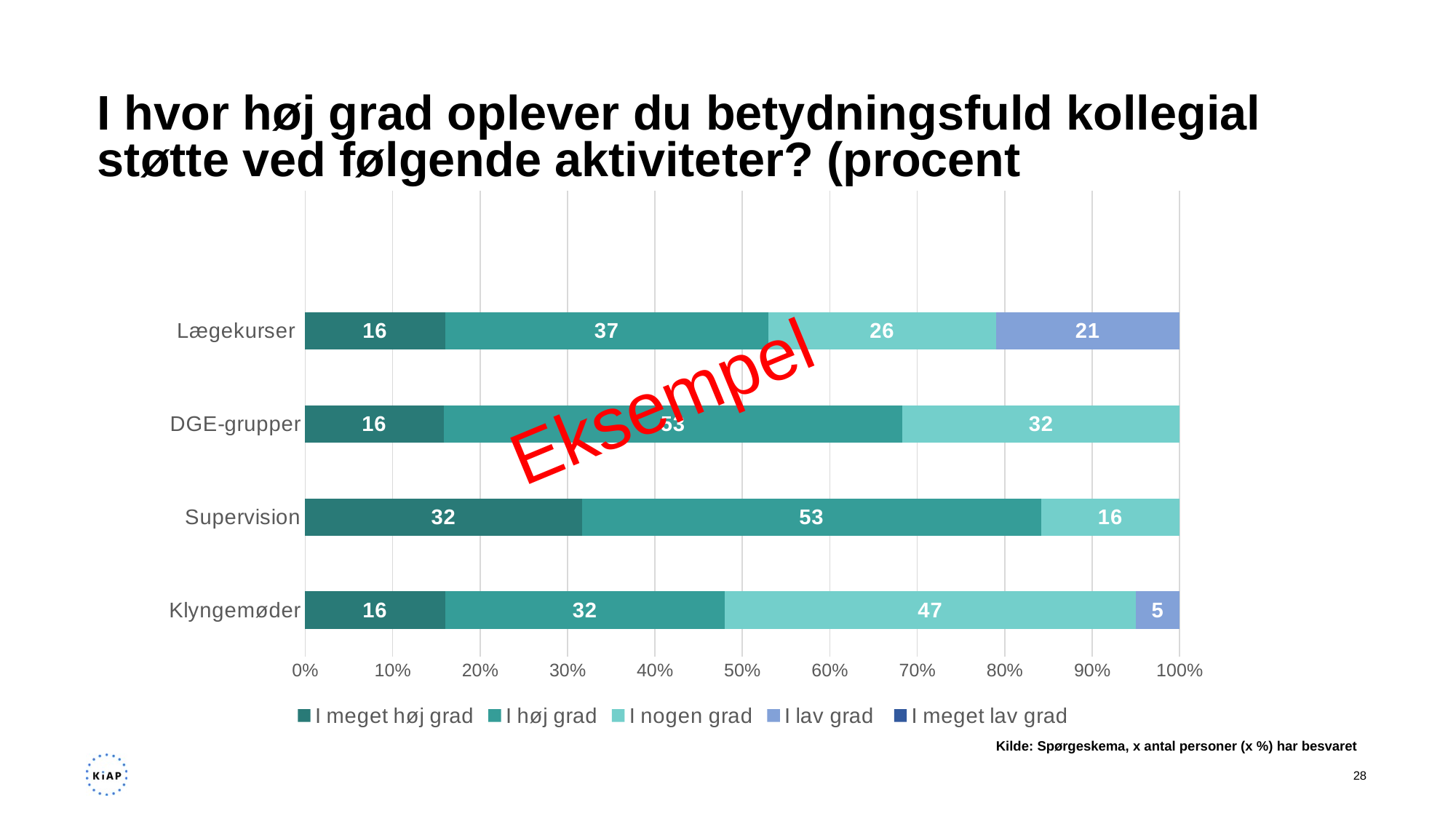
What is the difference between the 'I høj grad' value for Supervision and the 'I høj grad' value for Klyngemøder? 21 What is the value of 'I nogen grad' for Klyngemøder? 47 What is the value of 'I lav grad' for Lægekurser? 21 How many activities (categories) are shown on the chart? 4 How many series does the legend list? 5 Which activity has the highest value for 'I meget høj grad'? Supervision Is the 'I høj grad' value for Supervision greater or less than the 'I høj grad' value for Lægekurser? greater What type of chart is shown on the slide? stacked bar chart Which activity has the highest value for 'I nogen grad'? Klyngemøder What is the value of 'I høj grad' for Lægekurser? 37 What is the value of 'I nogen grad' for DGE-grupper? 32 What is the value of 'I meget høj grad' for Supervision? 32